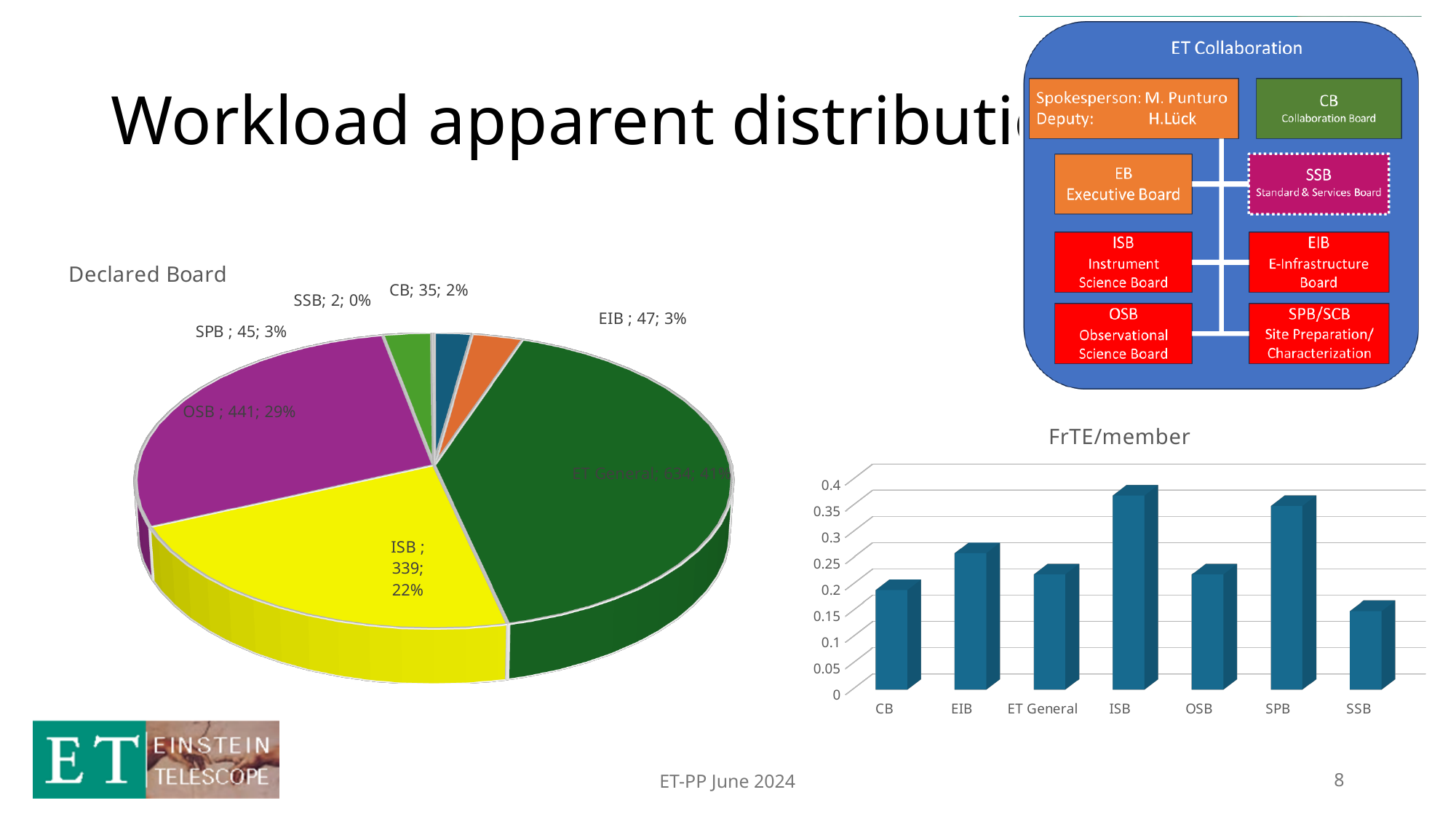
In the Declared Board pie chart, what share of the pie does SPB represent? 3% In the Declared Board pie chart, what is the difference between the values for ET General and OSB? 193 In the Declared Board pie chart, which category has the smallest slice? SSB In the FrTE/member chart, is the value for SPB greater or less than 0.3? greater In the FrTE/member chart, which category has the lowest bar? SSB In the Declared Board pie chart, how many slices are there? 7 In the Declared Board pie chart, what value is shown for ISB? 339 In the FrTE/member chart, which category has the highest bar? ISB In the Declared Board pie chart, what share of the pie does ET General represent? 41% In the Declared Board pie chart, what value is shown for OSB? 441 In the Declared Board pie chart, which category has the largest slice? ET General What kind of chart is the FrTE/member chart? bar chart